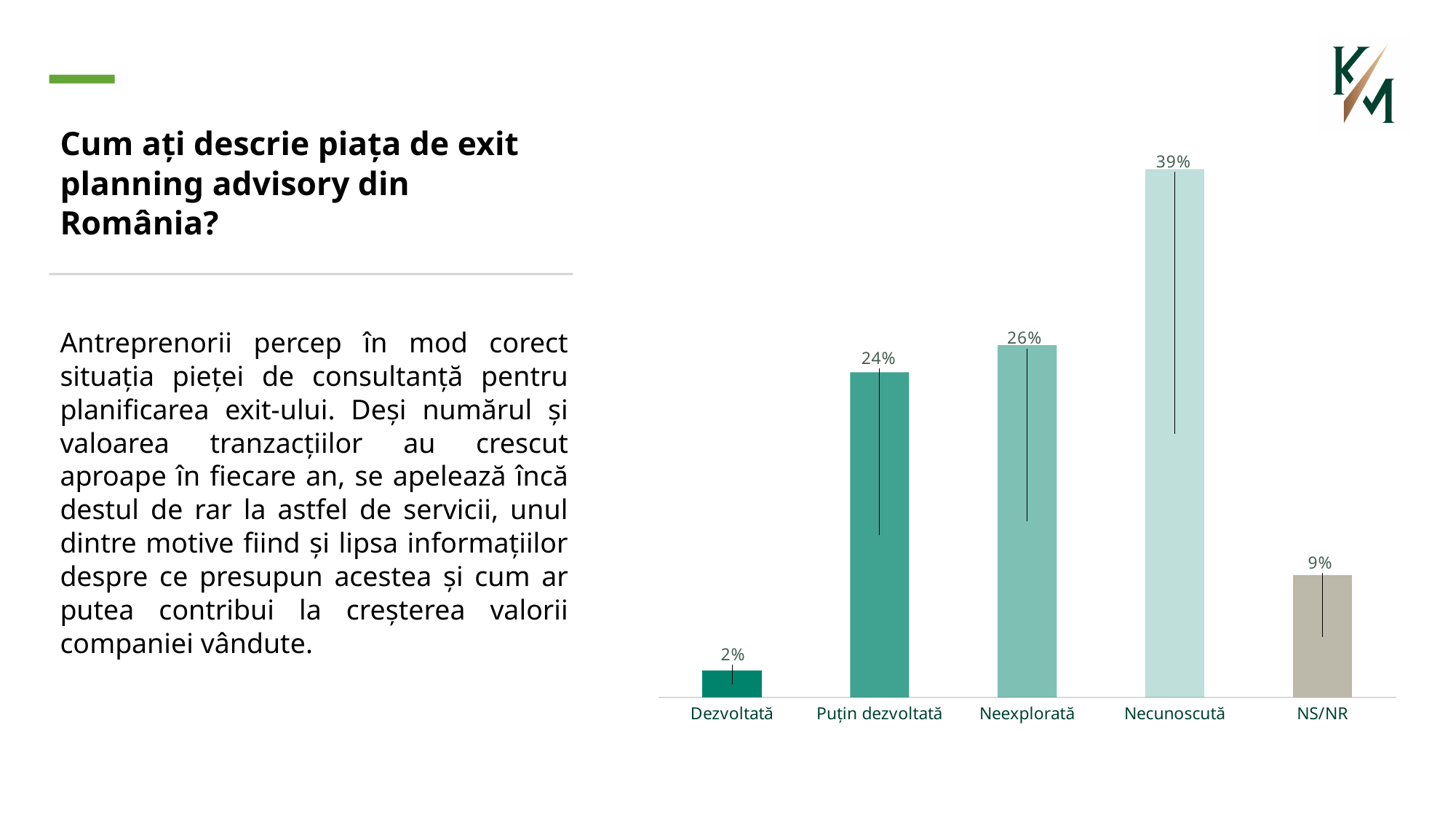
What is the difference between the values for Puțin dezvoltată and NS/NR? 15% What is the value for Dezvoltată? 2% What is the difference between the values for Necunoscută and Neexplorată? 13% Which category has the highest value? Necunoscută What is the title of the question the chart answers? Cum ați descrie piața de exit planning advisory din România? What is the value for NS/NR? 9% Which is larger, the value for Neexplorată or the value for Puțin dezvoltată? Neexplorată What is the value for Puțin dezvoltată? 24% What kind of chart is shown on the slide? Bar chart How many categories are shown on the chart? 5 What is the value for Necunoscută? 39% Which category has the lowest value? Dezvoltată